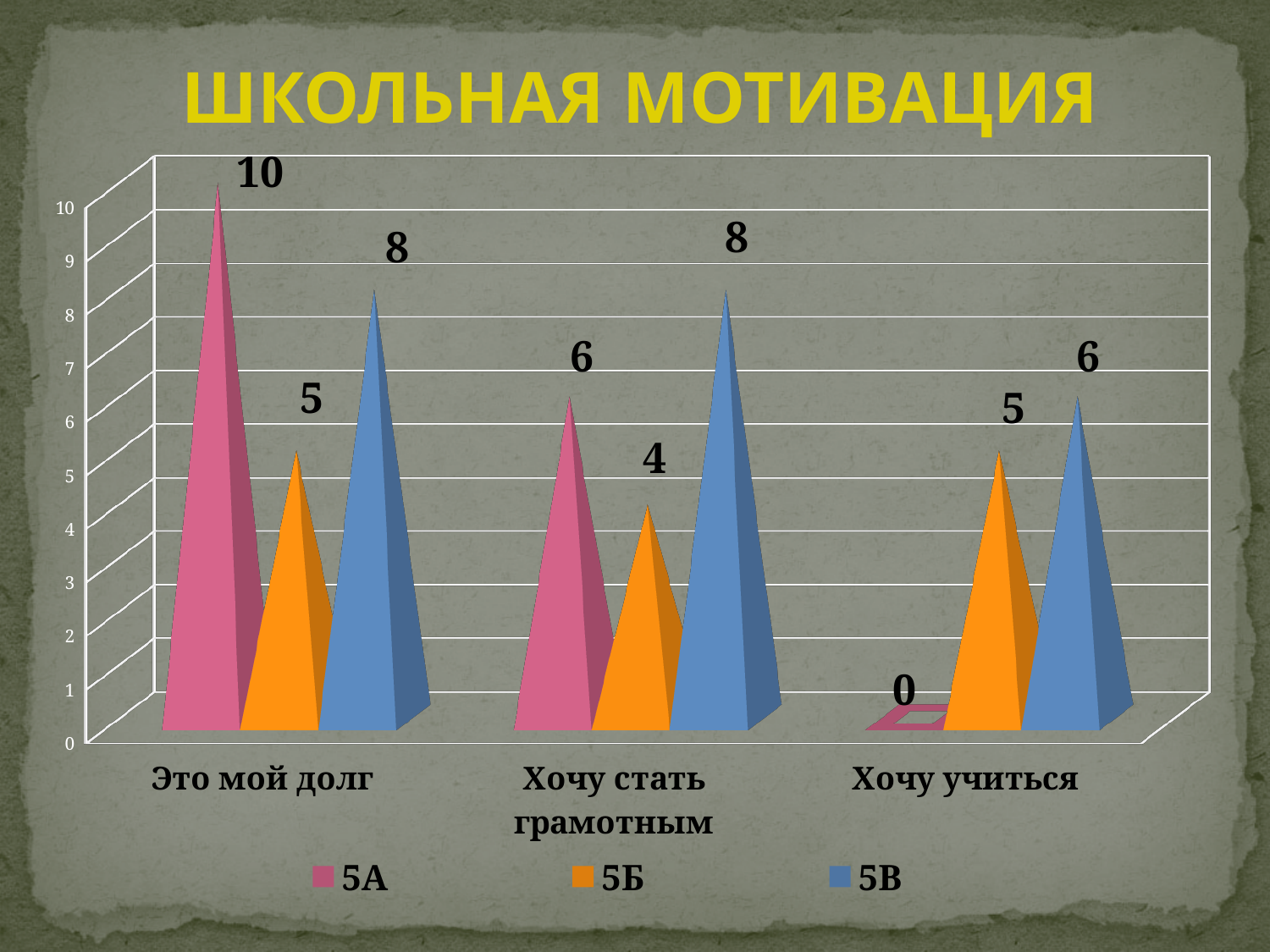
What is the title of the slide? ШКОЛЬНАЯ МОТИВАЦИЯ What is the value for 5Б in the category "Хочу стать грамотным"? 4 How many categories are shown on the x axis? 3 What is the value for 5А in the category "Это мой долг"? 10 Which is larger: the 5В value for "Хочу стать грамотным" or the 5В value for "Хочу учиться"? Хочу стать грамотным Which series has the highest value in the category "Это мой долг"? 5А Which series has the lowest value in the category "Хочу стать грамотным"? 5Б How many series does the legend list? 3 What kind of chart is shown on the slide? bar chart What is the value for 5А in the category "Хочу учиться"? 0 What is the value for 5В in the category "Хочу учиться"? 6 What is the difference between the 5А and 5Б values in the category "Это мой долг"? 5